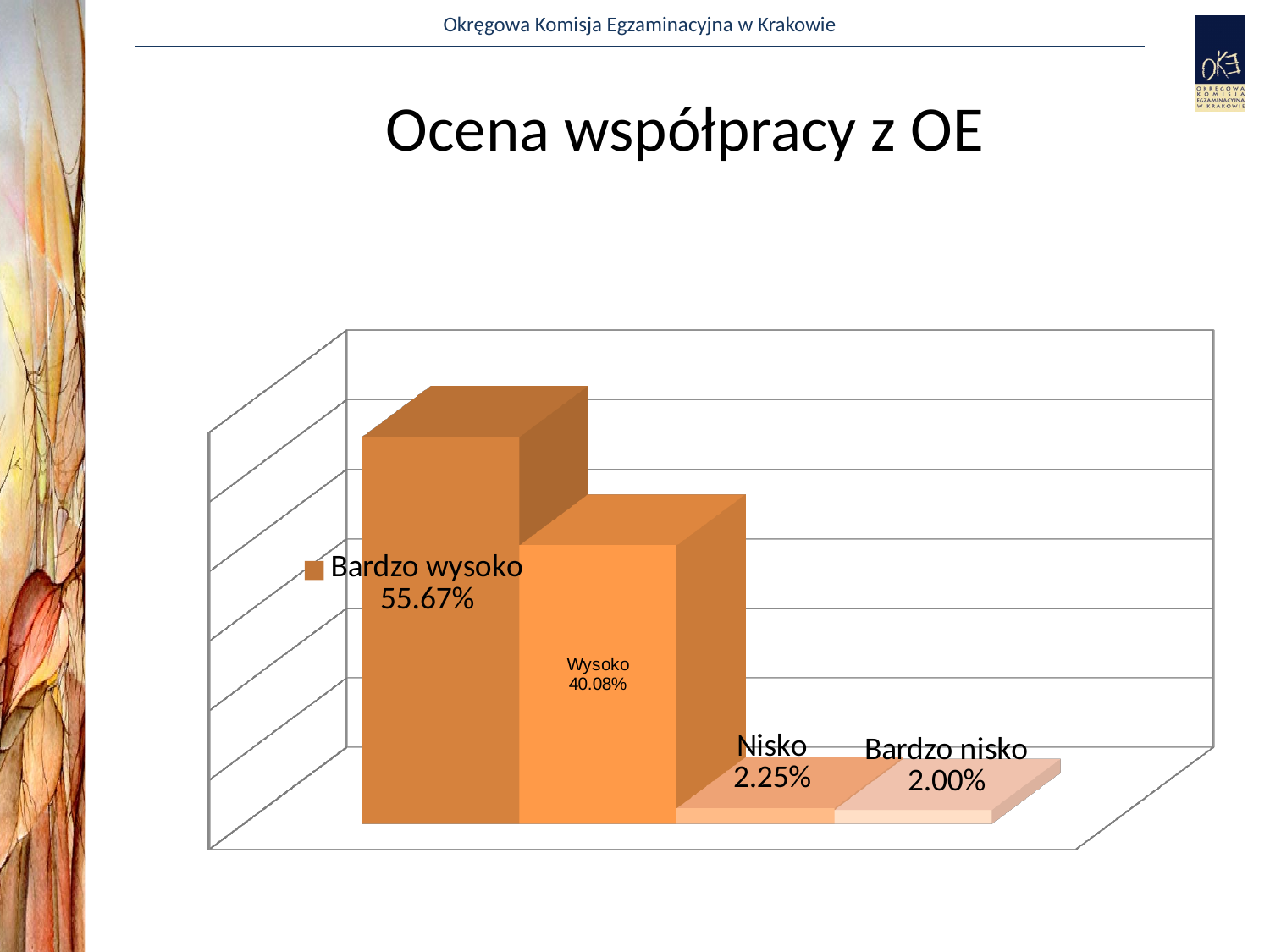
What is the value for Nisko? 2.25% What is the value for Bardzo nisko? 2.00% Which category has the lowest value? Bardzo nisko How many categories are shown in the chart? 4 Which category has the highest value? Bardzo wysoko What is the difference between the values for Bardzo wysoko and Wysoko? 15.59% What is the title of the slide containing the chart? Ocena współpracy z OE Which is larger, the value for Wysoko or the value for Nisko? Wysoko What is the difference between the values for Nisko and Bardzo nisko? 0.25% What is the value for Wysoko? 40.08% What kind of chart is shown on the slide? Bar chart What is the value for Bardzo wysoko? 55.67%